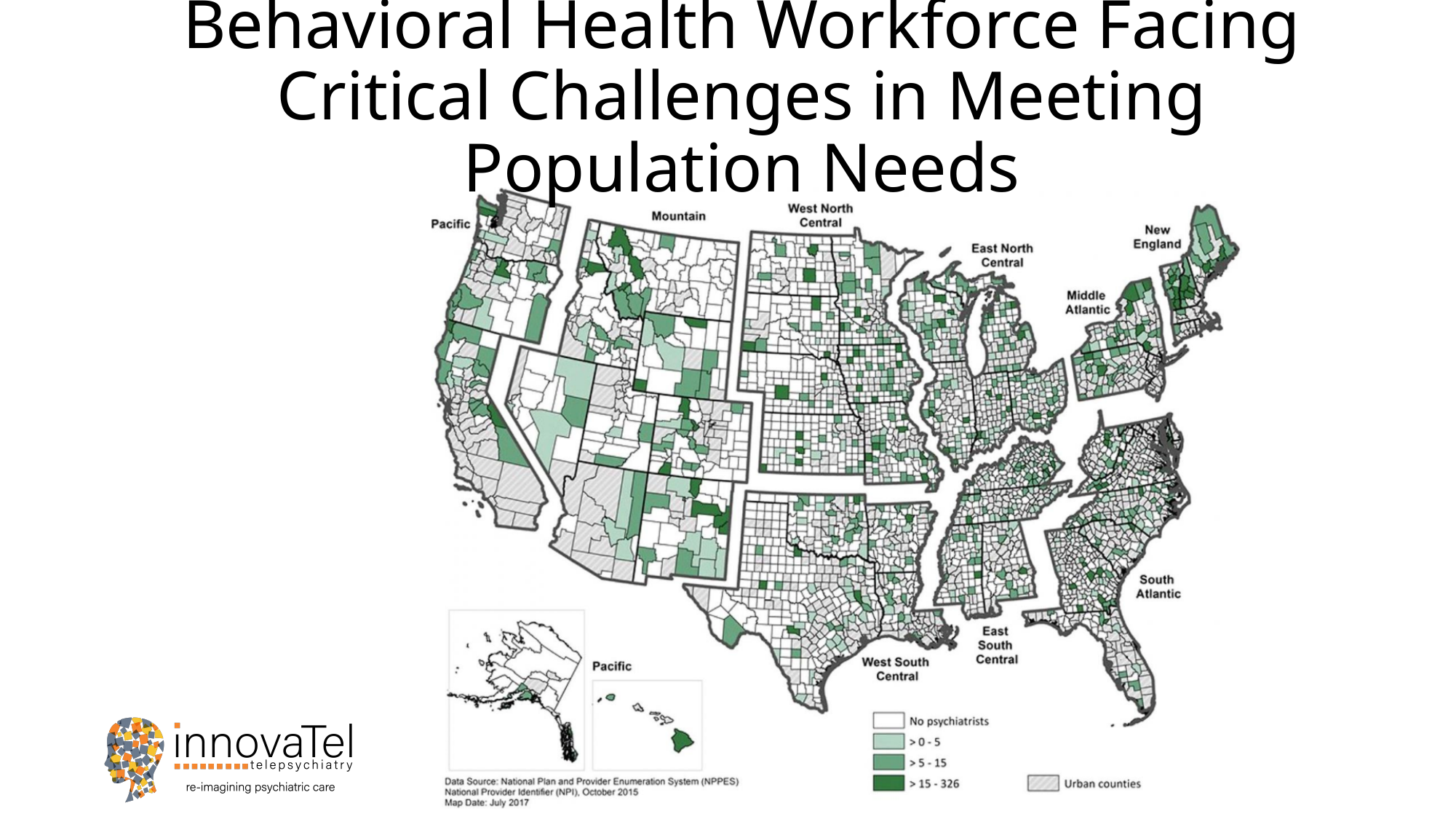
What does the darkest green shade in the map legend represent? > 15 - 326 What is the map date printed on the map? July 2017 How many shading categories for the number of psychiatrists does the map legend list? 4 What does the hatched (diagonal stripe) pattern on the map indicate? Urban counties What does a white (unshaded) county on the map represent? No psychiatrists What does the lightest green shade in the map legend represent? > 0 - 5 What kind of chart is shown on the slide? A map (choropleth map of U.S. counties)